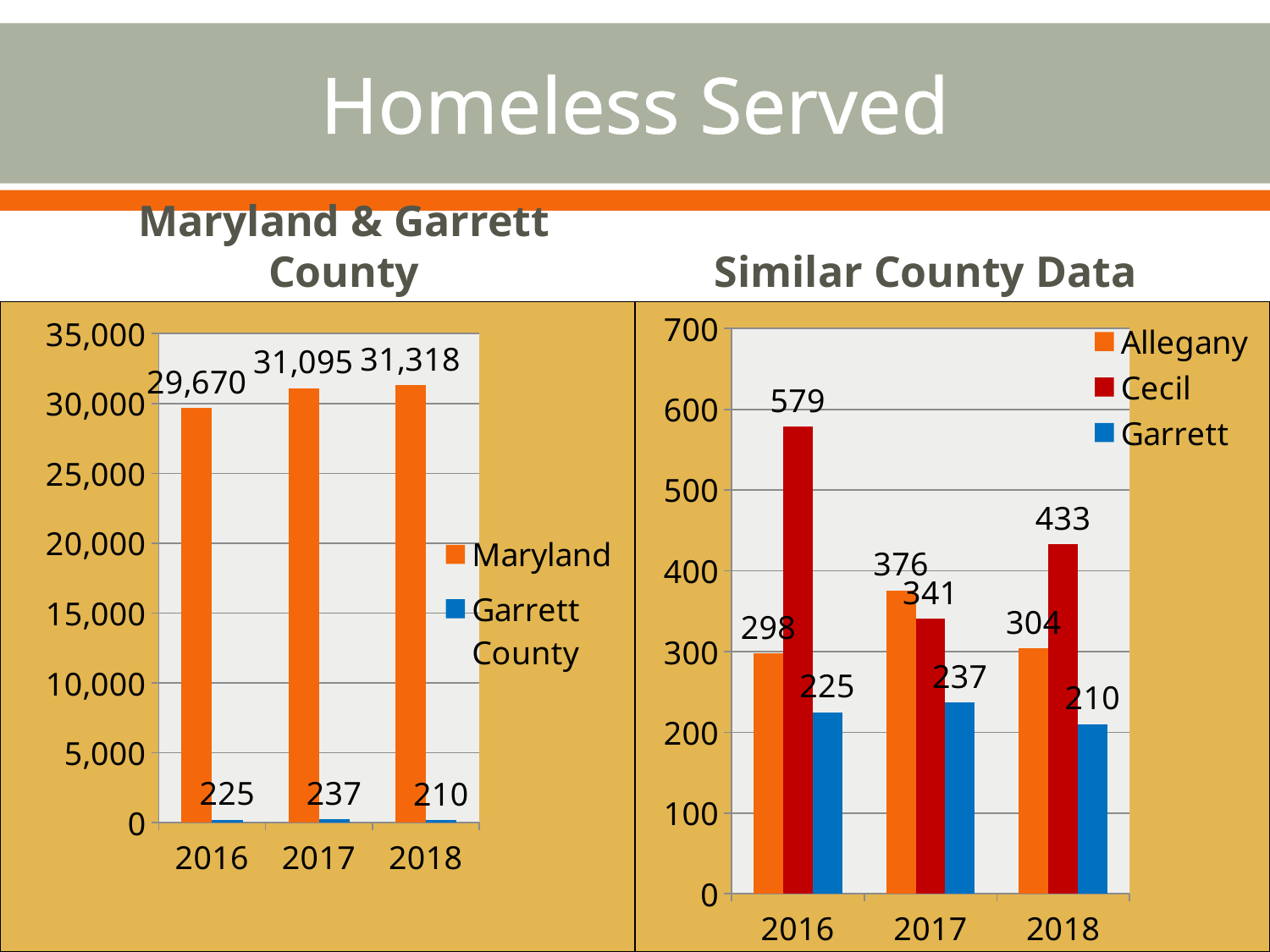
In the 'Similar County Data' chart, what is the difference between the Cecil values for 2016 and 2018? 146 In the 'Maryland & Garrett County' chart, what is the value for Maryland in 2017? 31,095 In the 'Similar County Data' chart, what is the value for Cecil in 2016? 579 What kind of chart is the 'Similar County Data' chart? bar chart In the 'Maryland & Garrett County' chart, what is the value for Garrett County in 2018? 210 In the 'Maryland & Garrett County' chart, what is the difference between the Maryland values for 2018 and 2016? 1,648 In the 'Similar County Data' chart, which county has the lowest value in 2017? Garrett In the 'Similar County Data' chart, what is the value for Allegany in 2018? 304 In the 'Maryland & Garrett County' chart, how many series does the legend list? 2 In the 'Similar County Data' chart, how many series does the legend list? 3 In the 'Maryland & Garrett County' chart, which year has the highest Maryland value? 2018 In the 'Similar County Data' chart, is the value for Allegany in 2017 larger or smaller than the value for Cecil in 2017? larger